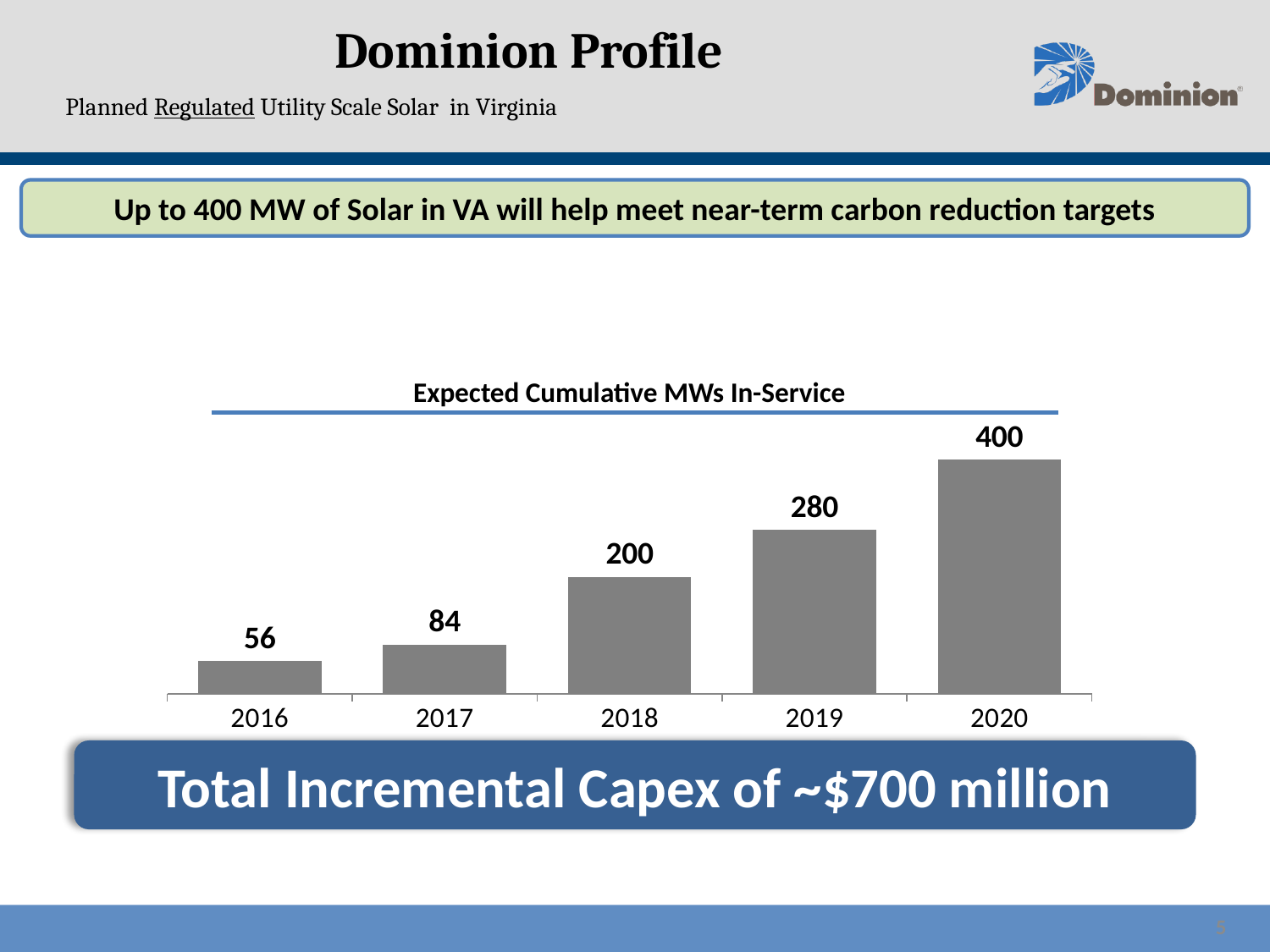
What is the title of the chart? Expected Cumulative MWs In-Service What is the difference between the values for 2019 and 2018? 80 Which year has the highest expected cumulative MWs in-service? 2020 What is the expected cumulative MWs in-service for 2016? 56 Do the values rise or fall from 2016 to 2020? Rise Which is larger, the value for 2019 or the value for 2017? 2019 How many years are shown on the x axis of the chart? 5 What is the expected cumulative MWs in-service for 2018? 200 What is the difference between the values for 2017 and 2016? 28 What kind of chart is shown on the slide? Bar chart Which year has the lowest expected cumulative MWs in-service? 2016 What is the expected cumulative MWs in-service for 2020? 400